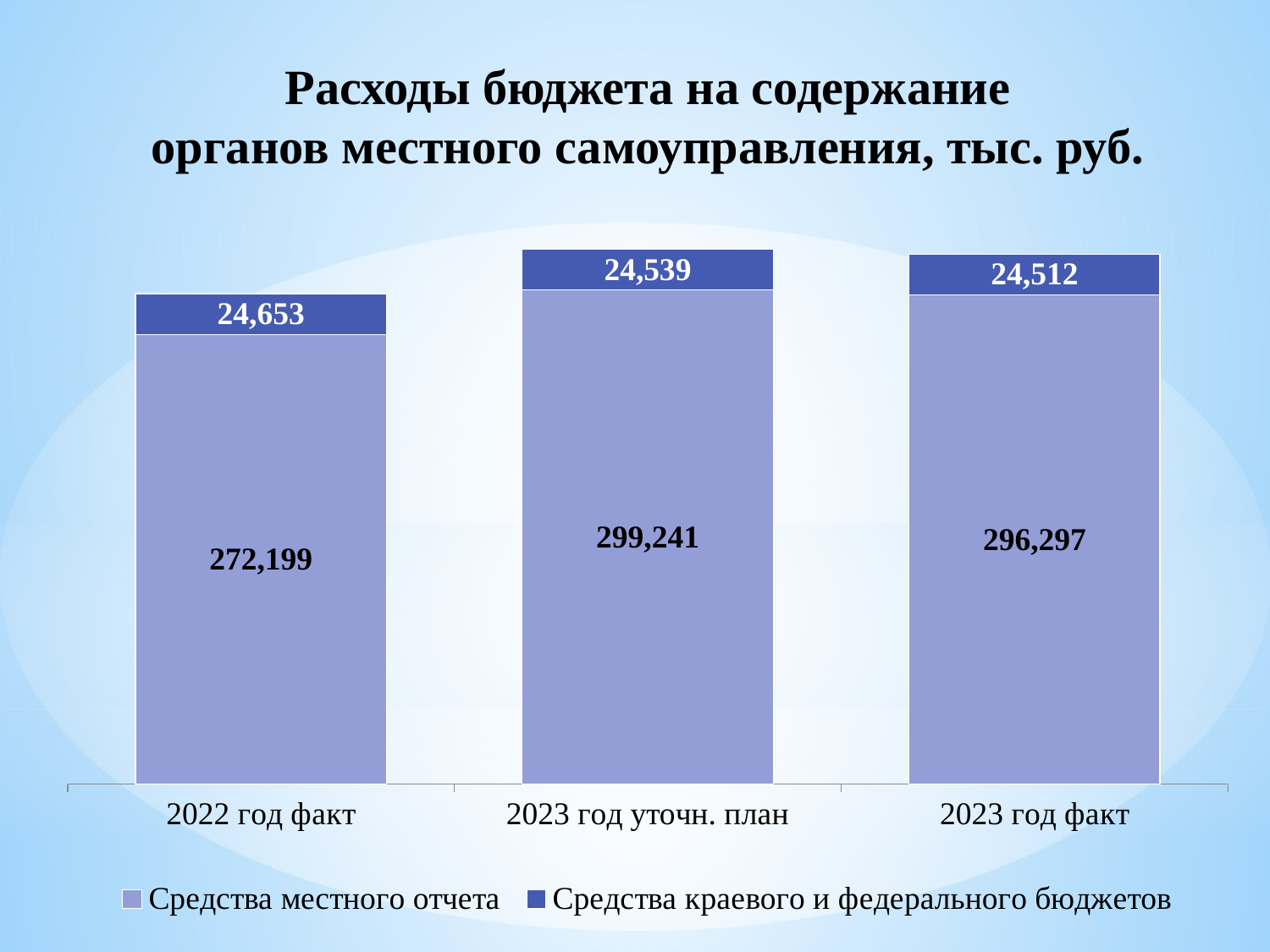
How many series does the legend list? 2 What is the difference between Средства местного отчета for 2023 год уточн. план and 2023 год факт? 2,944 What type of chart is shown on the slide? Stacked bar chart Which category has the highest value for Средства местного отчета? 2023 год уточн. план What is the value of Средства местного отчета for 2023 год факт? 296,297 What is the title of the chart? Расходы бюджета на содержание органов местного самоуправления, тыс. руб. What is the value of Средства местного отчета for 2022 год факт? 272,199 What is the total of the stacked bar for 2022 год факт? 296,852 Which category has the lowest value for Средства краевого и федерального бюджетов? 2023 год факт What is the value of Средства краевого и федерального бюджетов for 2023 год уточн. план? 24,539 How many categories are shown on the x axis? 3 Which is larger: Средства краевого и федерального бюджетов for 2022 год факт or for 2023 год факт? 2022 год факт